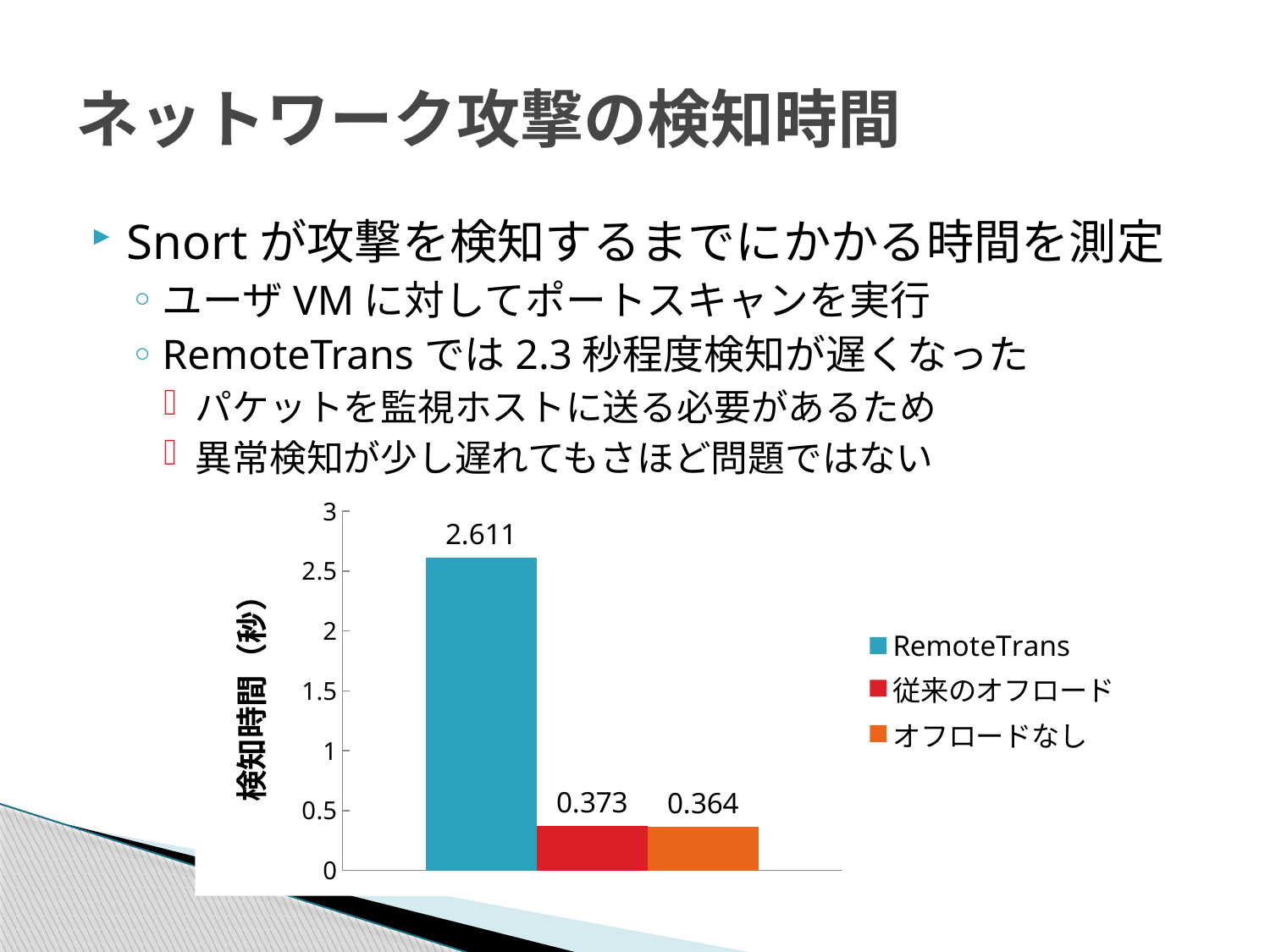
Which series has the highest detection time? RemoteTrans Which has a larger detection time, RemoteTrans or オフロードなし? RemoteTrans What is the detection time for オフロードなし? 0.364 How many series does the legend list? 3 What is the detection time for RemoteTrans? 2.611 What is the label of the vertical axis? 検知時間（秒） What kind of chart is shown on the slide? bar chart Is the value for RemoteTrans greater or less than 2.5? greater Which series has the lowest detection time? オフロードなし What is the detection time for 従来のオフロード? 0.373 What is the difference in detection time between 従来のオフロード and オフロードなし? 0.009 What is the difference in detection time between RemoteTrans and 従来のオフロード? 2.238